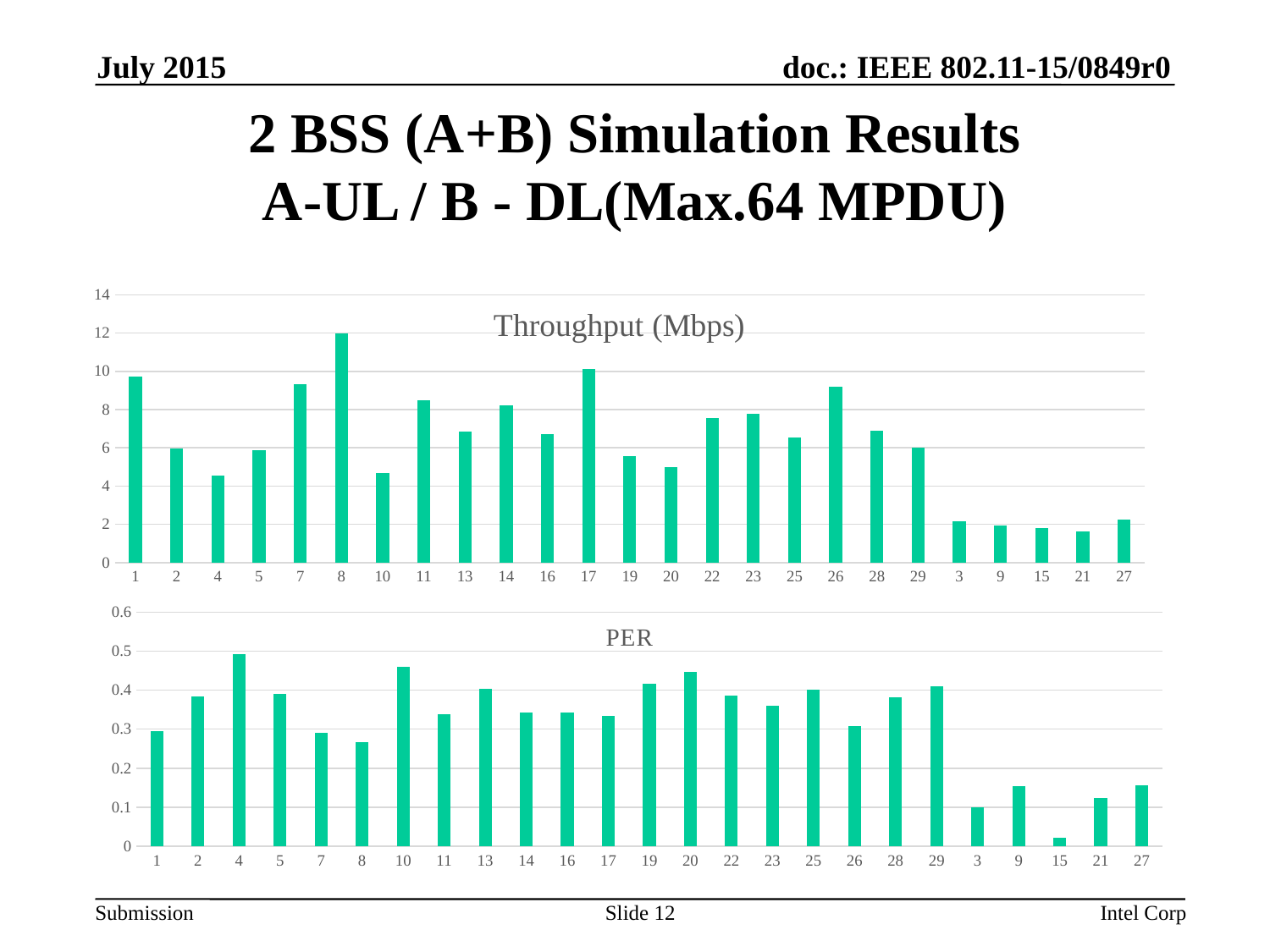
On the Throughput (Mbps) chart, which is larger, the value for category 17 or category 19? 17 How many categories are plotted on the PER chart? 25 On the Throughput (Mbps) chart, is the value for category 8 greater or less than 10? greater On the PER chart, which category has the lowest value? 15 What is the title of the upper chart on the slide? Throughput (Mbps) What is the title of the lower chart on the slide? PER On the Throughput (Mbps) chart, is the value for category 3 greater or less than 4? less On the PER chart, is the value for category 15 greater or less than 0.1? less On the Throughput (Mbps) chart, which category has the highest value? 8 On the PER chart, which is larger, the value for category 8 or category 10? 10 What kind of chart is the Throughput (Mbps) chart? bar chart